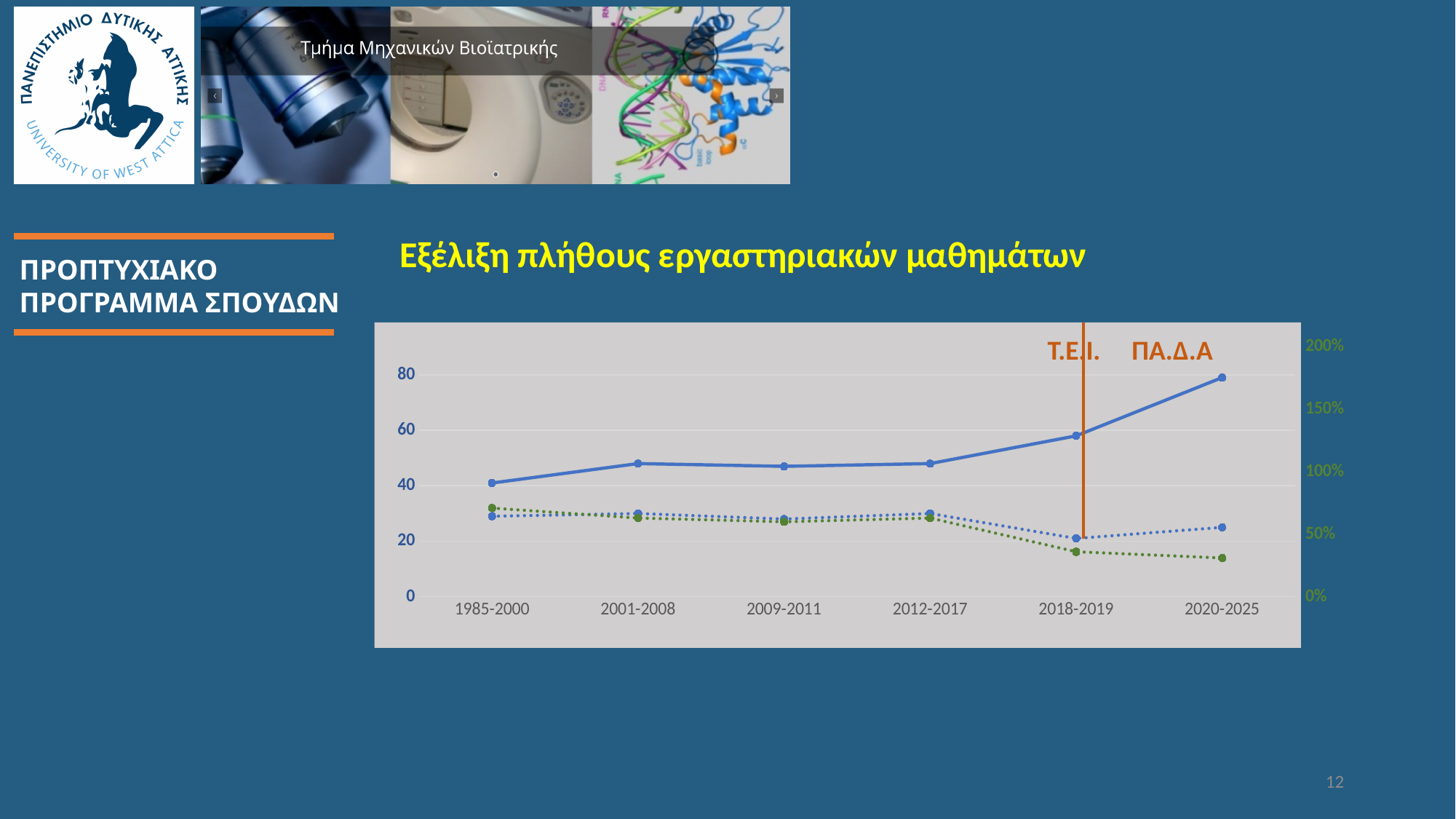
What two labels appear on either side of the vertical orange line in the chart? Τ.Ε.Ι. and ΠΑ.Δ.Α Which is larger for the solid blue line: the value for 2018-2019 or the value for 2020-2025? 2020-2025 Is the value of the dotted blue line for 2018-2019 greater or less than 40? less Is the value of the solid blue line for 2018-2019 greater or less than 40? greater Does the solid blue line rise or fall from 2012-2017 to 2020-2025? rise In which period does the solid blue line have its lowest value? 1985-2000 Is the value of the solid blue line for 2020-2025 greater or less than 60? greater What is the title of the chart? Εξέλιξη πλήθους εργαστηριακών μαθημάτων How many time periods are shown on the x axis of the chart? 6 What kind of chart is shown on the slide? line chart In which period does the solid blue line reach its highest value? 2020-2025